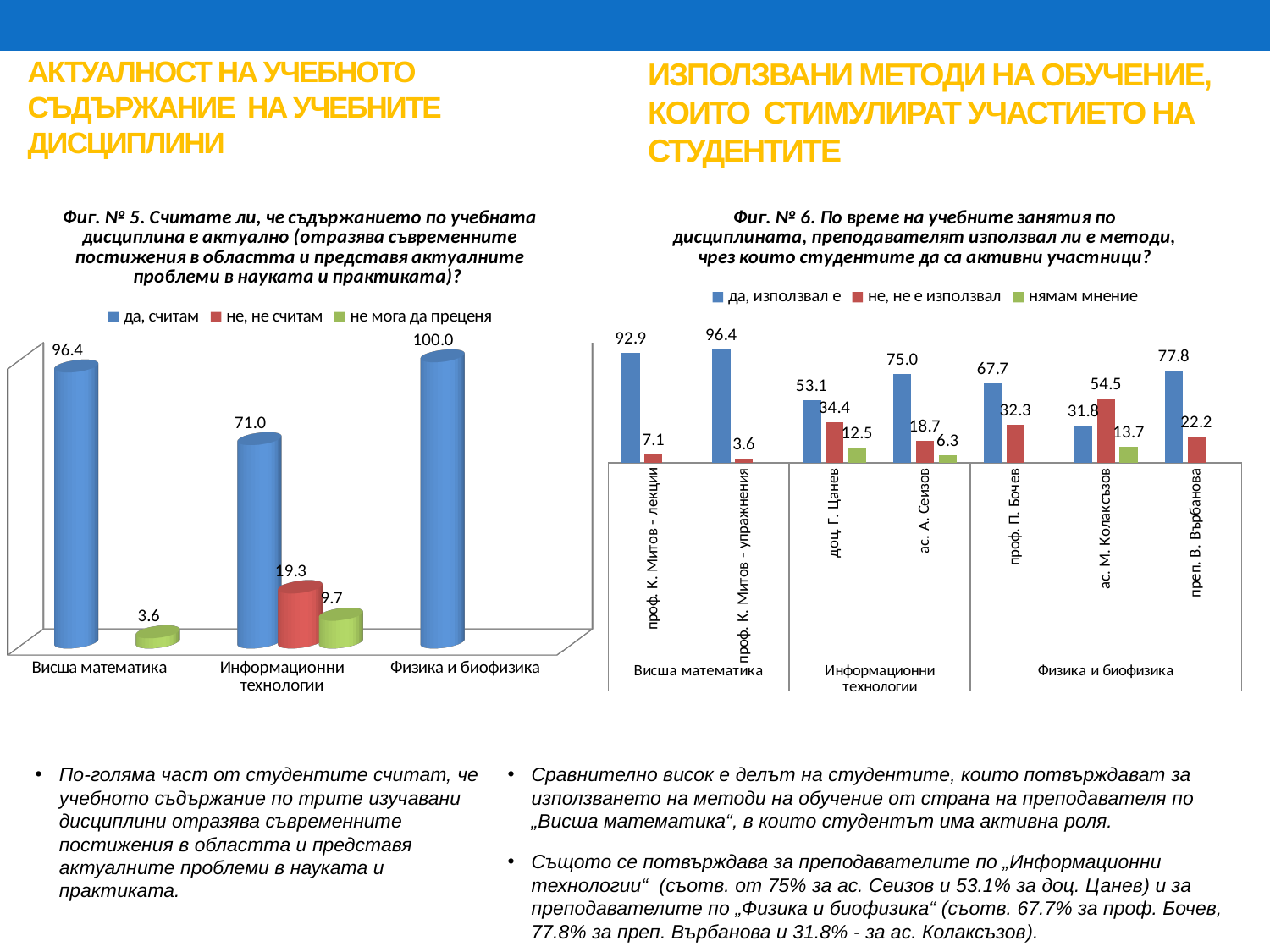
What type of chart is Фиг. № 6 (right)? Bar chart In the chart Фиг. № 5 (left), what is the value of "не, не считам" for Информационни технологии? 19.3 In the chart Фиг. № 6 (right), what is the value of "не, не е използвал" for ас. М. Колаксъзов? 54.5 In the chart Фиг. № 6 (right), which lecturer has the lowest value for "да, използвал е"? ас. М. Колаксъзов In the chart Фиг. № 5 (left), which category has the highest value for "да, считам"? Физика и биофизика In the chart Фиг. № 5 (left), what is the value of "да, считам" for Висша математика? 96.4 In the chart Фиг. № 5 (left), how many series does the legend list? 3 In the chart Фиг. № 6 (right), which lecturer has the highest value for "да, използвал е"? проф. К. Митов - упражнения In the chart Фиг. № 6 (right), which is larger: the "да, използвал е" value for проф. П. Бочев or for преп. В. Върбанова? преп. В. Върбанова In the chart Фиг. № 6 (right), what is the difference between the "да, използвал е" values for проф. К. Митов - лекции and доц. Г. Цанев? 39.8 In the chart Фиг. № 5 (left), what is the difference between the "да, считам" values for Физика и биофизика and Информационни технологии? 29.0 In the chart Фиг. № 6 (right), what is the value of "да, използвал е" for ас. А. Сеизов? 75.0